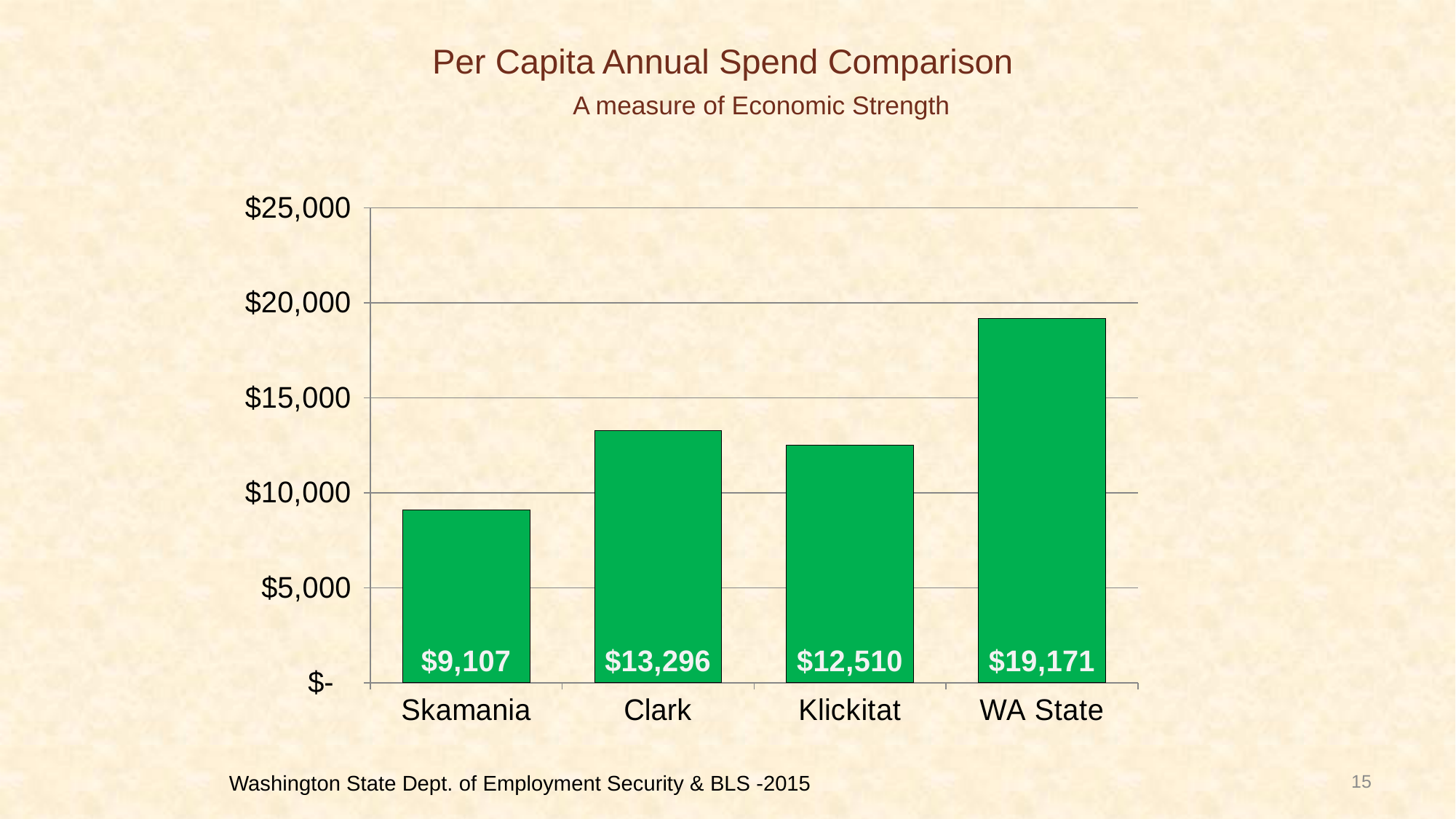
Which has a higher per capita annual spend, Clark or Klickitat? Clark What is the per capita annual spend for Skamania? $9,107 What is the per capita annual spend for WA State? $19,171 What kind of chart is shown on the slide? Bar chart What is the difference between the per capita annual spend for WA State and Skamania? $10,064 Which category has the highest per capita annual spend? WA State Which category has the lowest per capita annual spend? Skamania Is the value for Skamania greater or less than $10,000? less What is the difference between the per capita annual spend for Clark and Klickitat? $786 What is the per capita annual spend for Clark? $13,296 How many categories are shown on the chart? 4 What is the per capita annual spend for Klickitat? $12,510